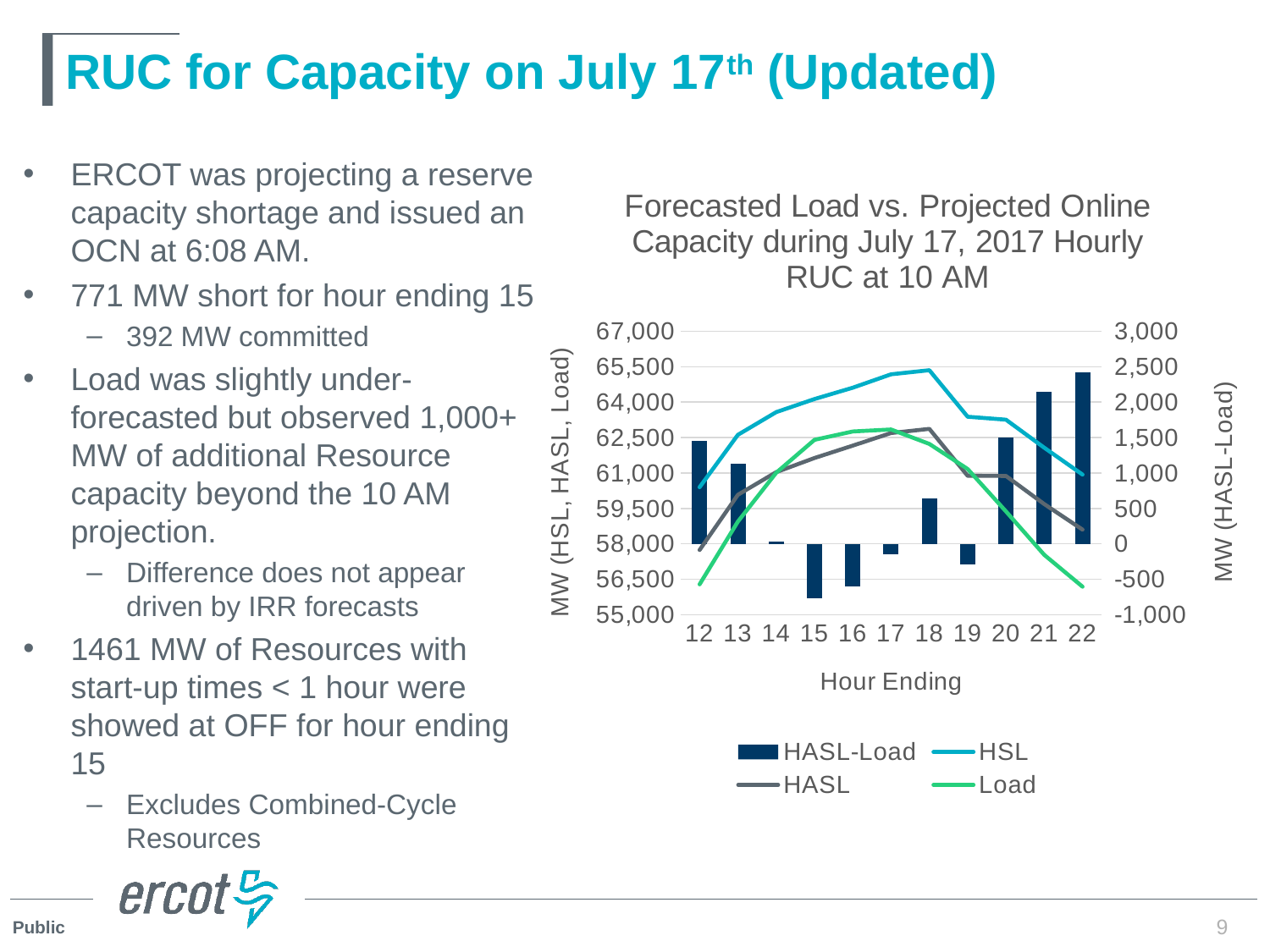
What kind of chart is shown on the slide? Combination bar and line chart At which hour ending is the HASL-Load bar lowest? 15 Is the HSL value for hour ending 18 greater or less than 65,000? greater How many series does the legend list? 4 How many hour-ending categories are shown on the x axis? 11 What is the title of the x axis? Hour Ending Does the Load line rise or fall from hour ending 18 to hour ending 22? fall Is the HASL-Load value for hour ending 22 greater or less than 2,000? greater Which series is plotted as bars? HASL-Load Is the HASL-Load value for hour ending 15 greater or less than 0? less At hour ending 22, which is higher, HSL or Load? HSL At which hour ending is the HASL-Load bar highest? 22